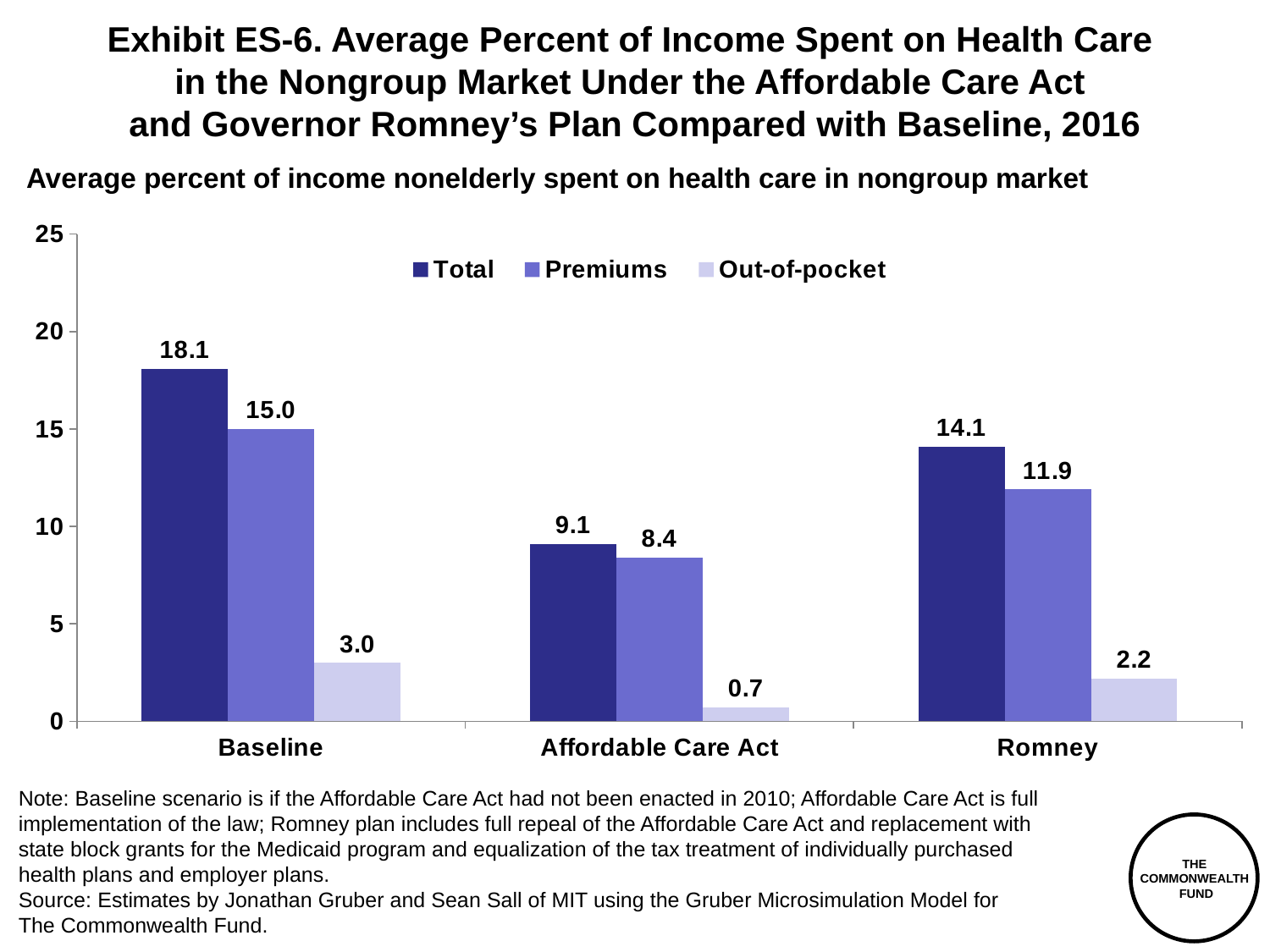
What kind of chart is shown on the slide? Bar chart Which category has the highest Total value? Baseline What is the Premiums value for the Affordable Care Act? 8.4 Which category has the lowest Out-of-pocket value? Affordable Care Act How many series does the legend list? 3 How many categories are shown on the x axis? 3 What is the maximum value shown on the y axis? 25 Which is larger, the Premiums value for Baseline or the Total value for Romney? Premiums value for Baseline What is the difference between the Total values for Baseline and the Affordable Care Act? 9.0 What is the Total value for Baseline? 18.1 What is the Out-of-pocket value for Romney? 2.2 What is the difference between the Premiums values for Romney and the Affordable Care Act? 3.5